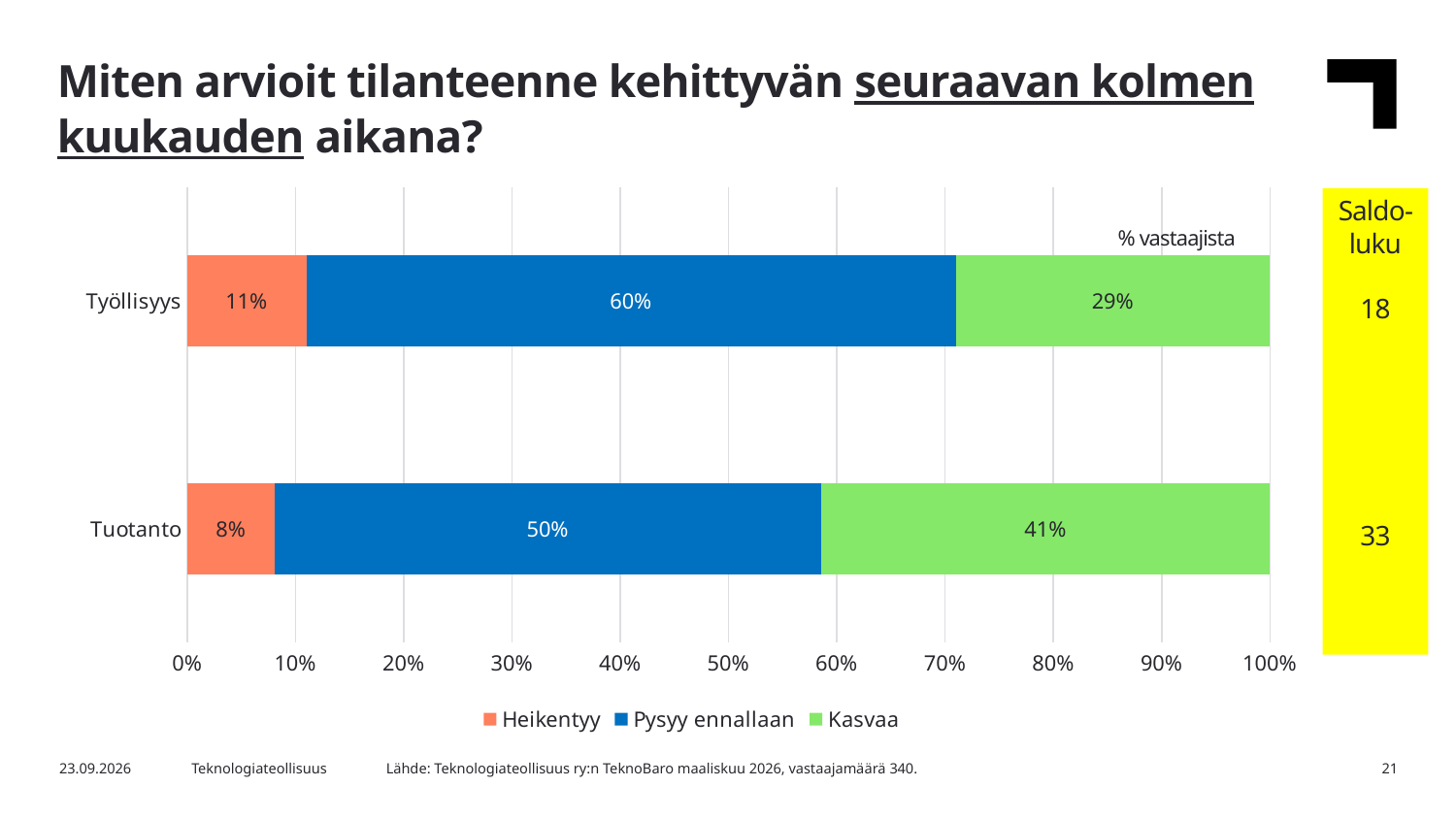
What is the difference between the 'Kasvaa' values for Tuotanto and Työllisyys? 12 percentage points Which category has the higher 'Pysyy ennallaan' share, Työllisyys or Tuotanto? Työllisyys What is the 'Kasvaa' value for Työllisyys? 29% Which category has the lowest 'Heikentyy' value? Tuotanto What kind of chart is shown on the slide? Stacked bar chart What is the 'Pysyy ennallaan' value for Tuotanto? 50% What is the Saldoluku value shown for Tuotanto? 33 What percentage of respondents expect Työllisyys to 'Heikentyy'? 11% How many series does the legend list? 3 How many categories are shown on the y axis of the chart? 2 What is the 'Kasvaa' value for Tuotanto? 41% Which series is shown in green in the legend? Kasvaa